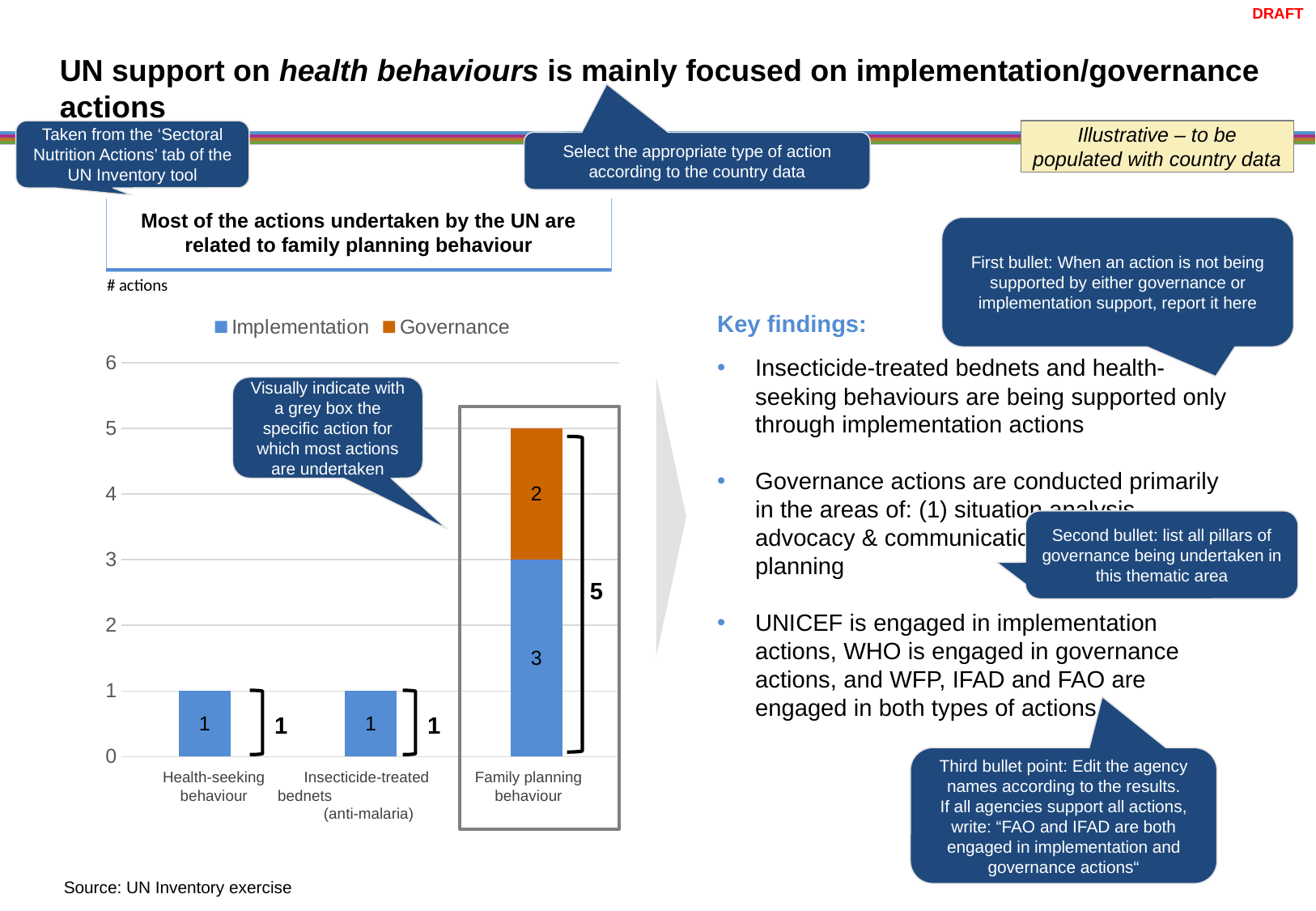
Which colour represents Governance in the legend? Orange What is the title of the chart? Most of the actions undertaken by the UN are related to family planning behaviour What is the total number of actions for Family planning behaviour? 5 What is the Governance value for Family planning behaviour? 2 What is the Implementation value for Family planning behaviour? 3 What kind of chart is shown? Stacked bar chart What is the Implementation value for Health-seeking behaviour? 1 How many series does the legend list? 2 How many categories are shown on the x axis? 3 Which is larger for Family planning behaviour: Implementation or Governance? Implementation Which category has the highest total number of actions? Family planning behaviour What is the difference between the Implementation and Governance values for Family planning behaviour? 1